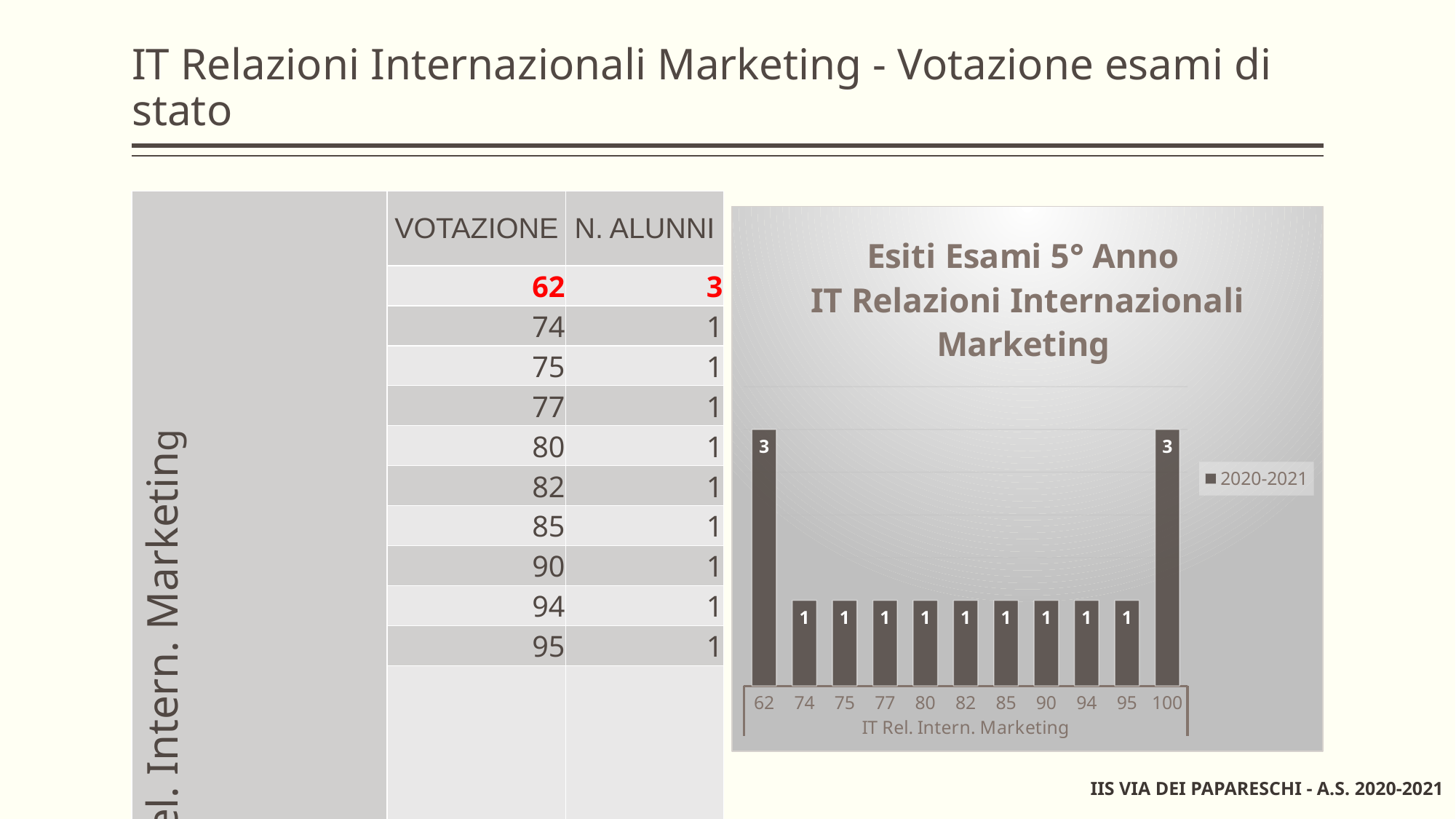
How many categories are shown on the x axis of the chart? 11 What is the difference between the value for 62 and the value for 74? 2 Which is larger, the value for 100 or the value for 95? 100 What is the value for the 85 category in the chart? 1 What is the value for the 100 category in the chart? 3 What series name is shown in the chart legend? 2020-2021 What is the value for the 62 category in the chart? 3 What type of chart is shown on the slide? bar chart What is the x-axis title of the chart? IT Rel. Intern. Marketing How many series does the chart legend list? 1 Which categories have the highest value in the chart? 62 and 100 What is the value for the 74 category in the chart? 1